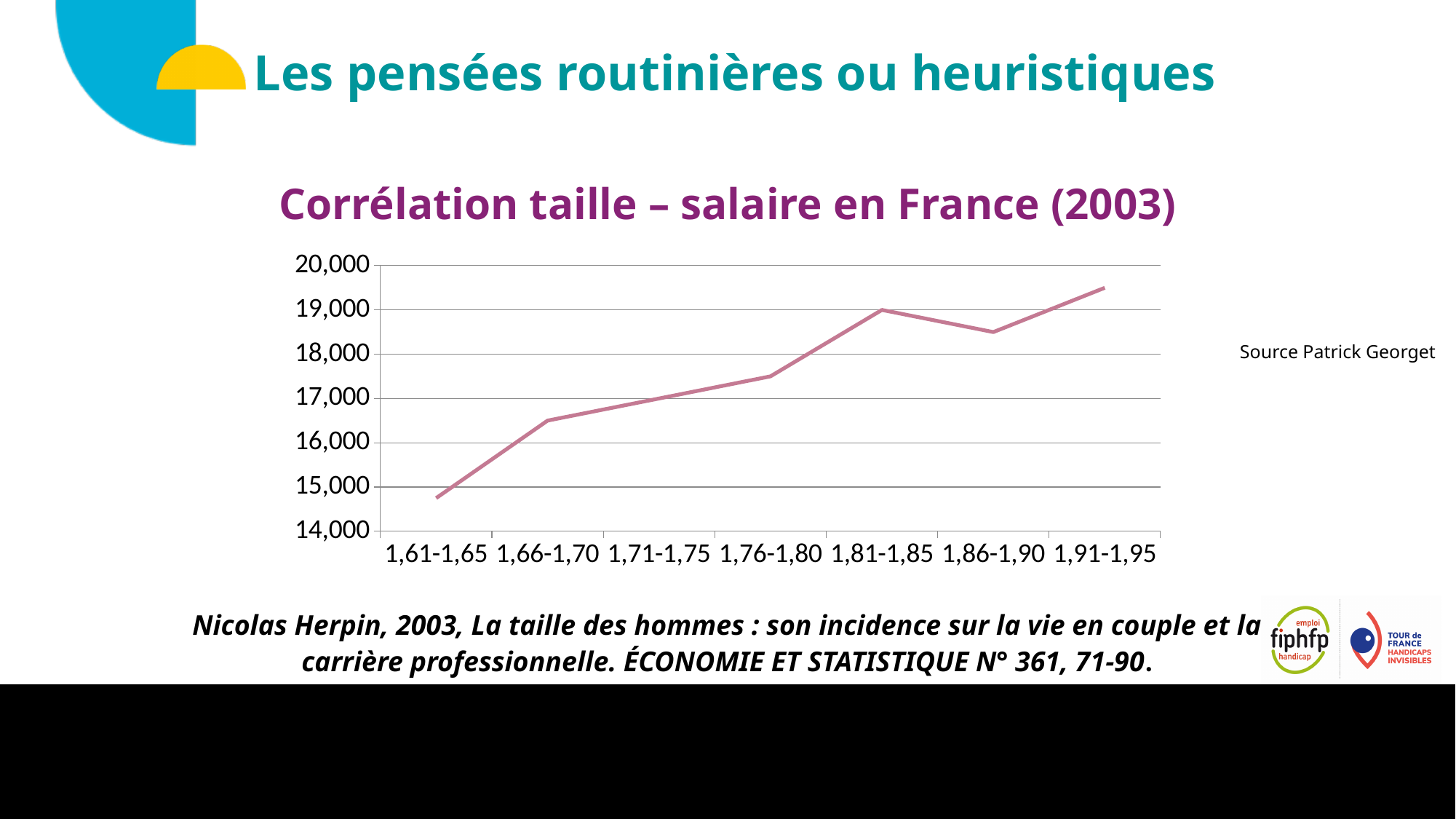
How many height categories are shown on the x axis of the chart? 7 Is the value for 1,66-1,70 greater or less than 16,000? greater Is the value for 1,91-1,95 greater or less than 19,000? greater Is the value for 1,86-1,90 greater or less than 18,000? greater Which height category has the highest value in the chart? 1,91-1,95 Which height category has the lowest value in the chart? 1,61-1,65 Which has the larger value, 1,81-1,85 or 1,86-1,90? 1,81-1,85 What kind of chart is shown on the slide? line chart Overall, do the values rise or fall from the shortest to the tallest height category? rise What is the title of the chart? Corrélation taille – salaire en France (2003)